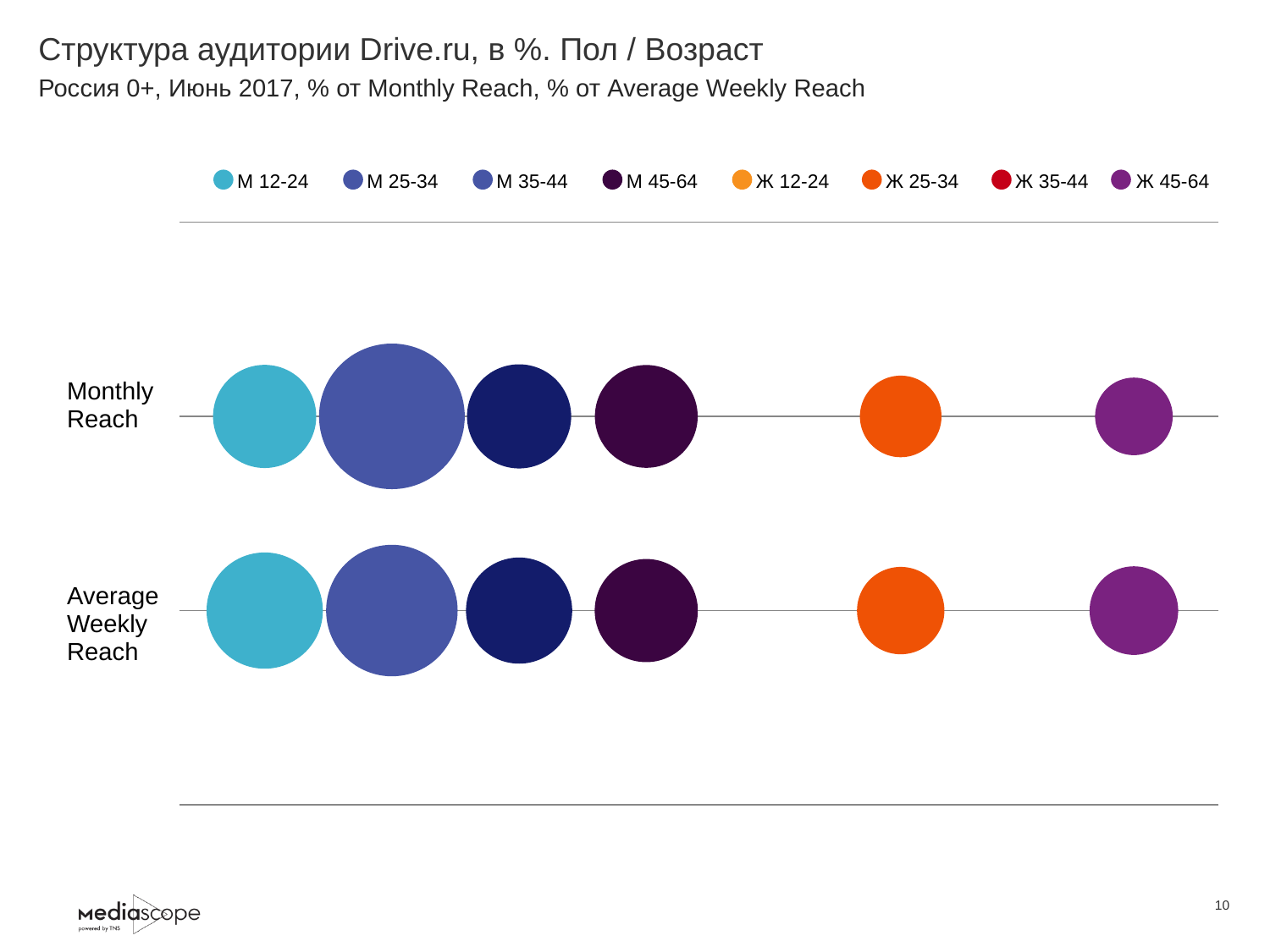
In the Monthly Reach row, which bubble is larger: М 45-64 or Ж 25-34? М 45-64 In the Average Weekly Reach row, which bubble is larger: М 25-34 or Ж 25-34? М 25-34 In the Monthly Reach row, which bubble is larger: М 25-34 or Ж 45-64? М 25-34 What is the title of the chart on the slide? Структура аудитории Drive.ru, в %. Пол / Возраст What kind of chart is shown on the slide? Bubble chart How many categories are shown on the vertical axis of the chart? 2 How many bubbles are visible in the Monthly Reach row? 6 Which series has the largest bubble in the Monthly Reach row? М 25-34 How many series does the legend list? 8